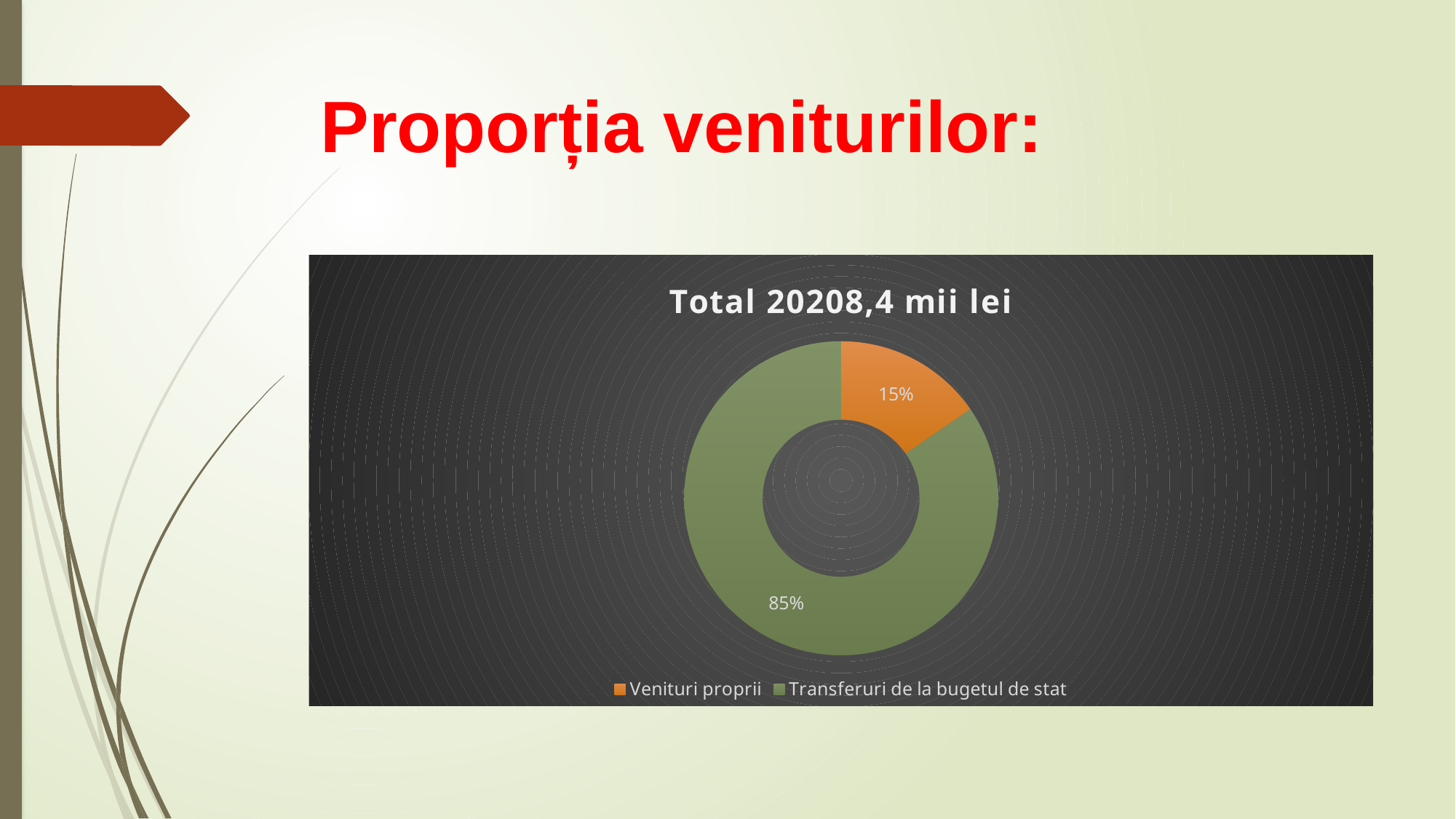
What kind of chart is shown on the slide? Doughnut chart Which category has the smallest share? Venituri proprii Which category has the largest share? Transferuri de la bugetul de stat What is the title of the chart? Total 20208,4 mii lei What colour represents Venituri proprii in the chart? Orange Which is larger, Venituri proprii or Transferuri de la bugetul de stat? Transferuri de la bugetul de stat What is the difference in percentage points between Transferuri de la bugetul de stat and Venituri proprii? 70 What share of the chart does Venituri proprii represent? 15% What share of the chart does Transferuri de la bugetul de stat represent? 85% How many categories are shown in the chart? 2